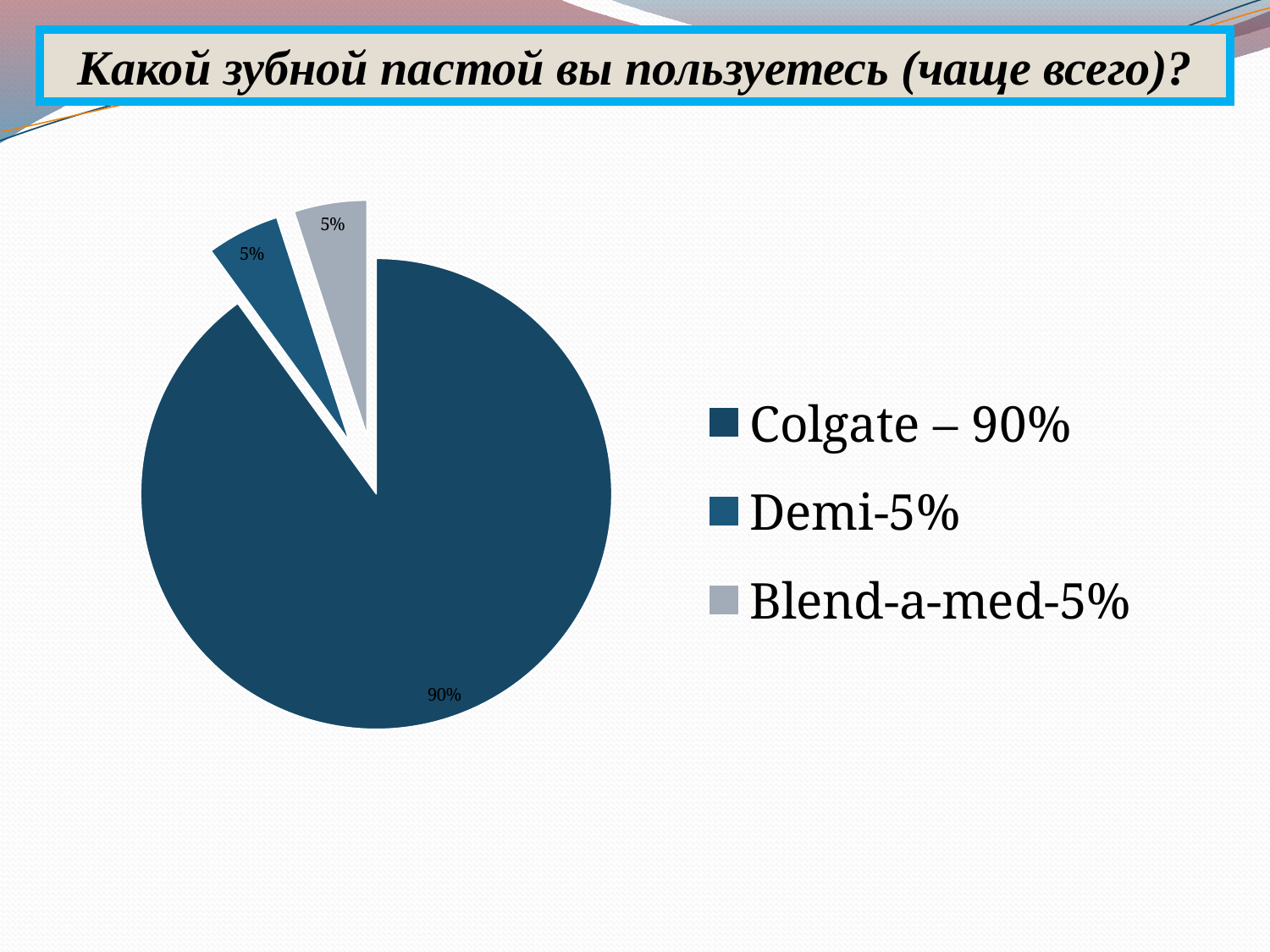
What is the combined share of Demi and Blend-a-med? 10% What share of the pie does Blend-a-med have? 5% Which toothpaste has the largest slice of the pie? Colgate How many entries does the legend list? 3 What is the title of the slide above the chart? Какой зубной пастой вы пользуетесь (чаще всего)? What share of the pie does Colgate have? 90% What is the difference between the Colgate share and the Demi share? 85% What kind of chart is shown on the slide? pie chart Which legend entry is shown in light grey? Blend-a-med-5% Which is larger, the Colgate slice or the Blend-a-med slice? Colgate How many slices does the pie chart have? 3 What share of the pie does Demi have? 5%